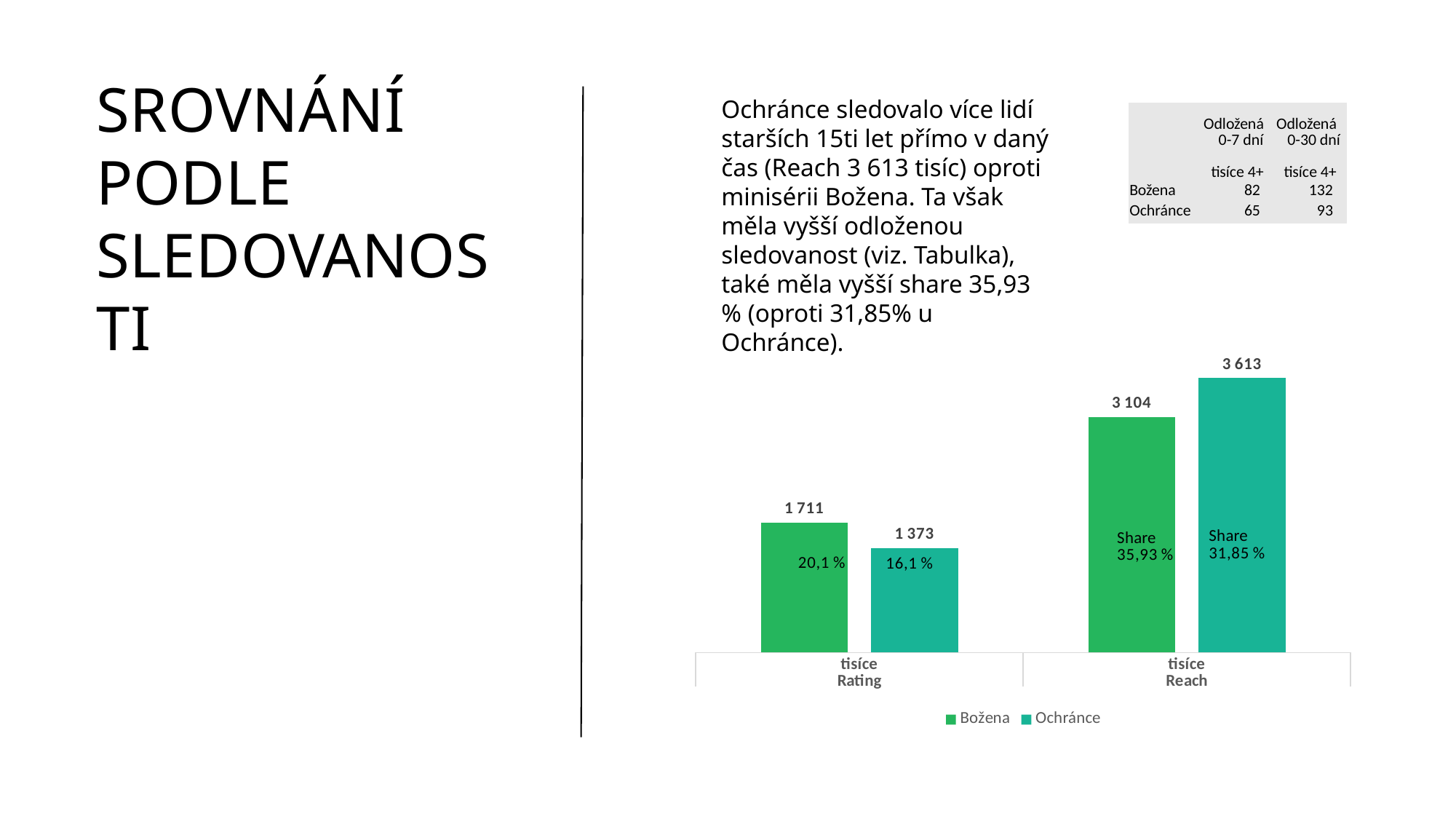
How many categories are shown on the x axis of the chart? 2 Which bar in the chart has the highest value? Ochránce, tisíce Reach In the tisíce Rating category, which series has the larger value, Božena or Ochránce? Božena What is the value for Ochránce in the tisíce Rating category? 1 373 What is the value for Božena in the tisíce Rating category? 1 711 How many series does the chart legend list? 2 What is the value for Božena in the tisíce Reach category? 3 104 What share percentage is printed inside the Božena bar in the tisíce Reach category? 35,93 % Which bar in the chart has the lowest value? Ochránce, tisíce Rating What is the value for Ochránce in the tisíce Reach category? 3 613 What kind of chart is shown on the slide? bar chart What is the difference between the Ochránce and Božena values in the tisíce Reach category? 509